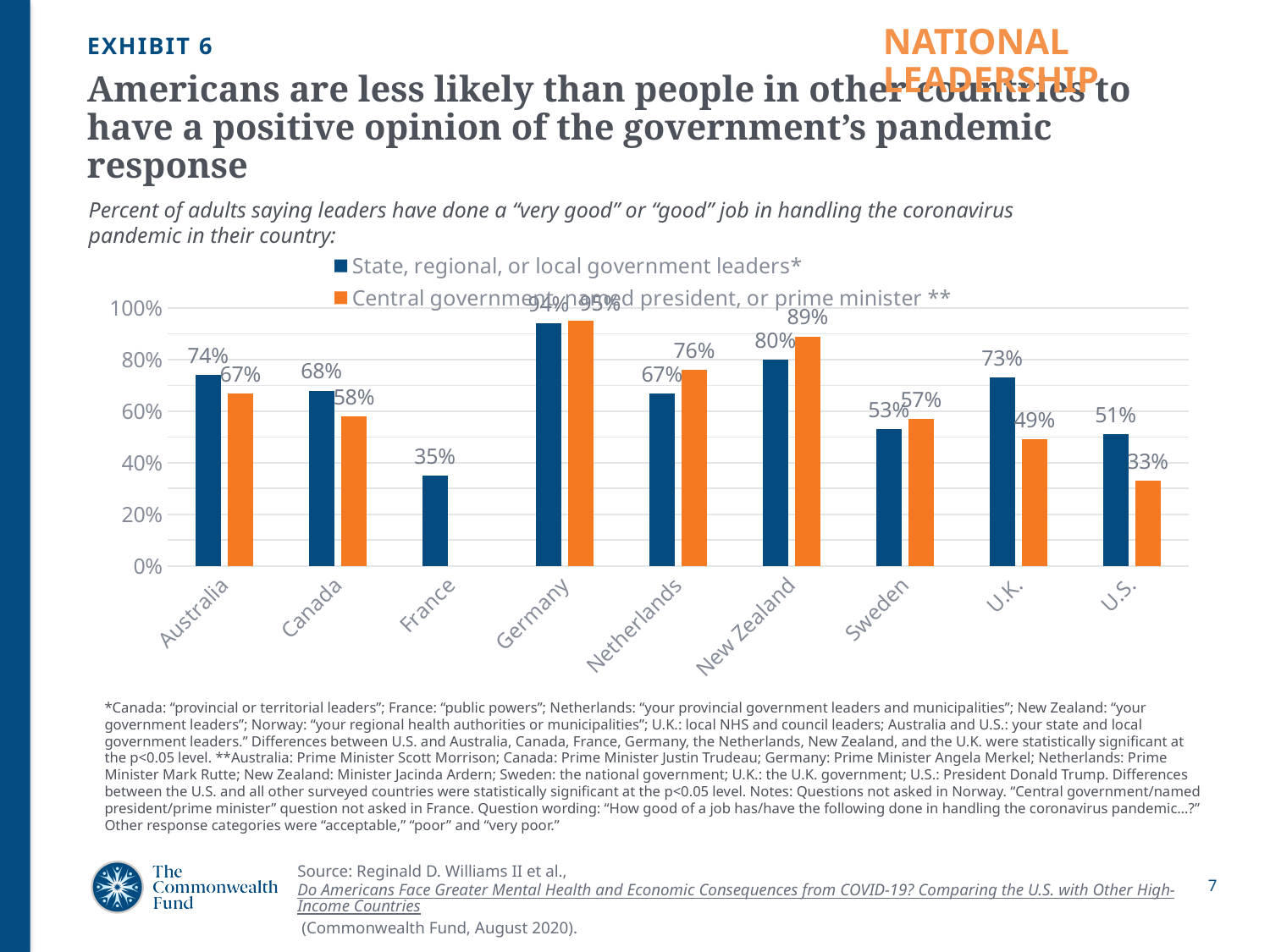
Which country has the highest value for state, regional, or local government leaders? Germany What type of chart is shown on the slide? Bar chart How many countries are shown on the x axis of the chart? 9 Which country has the lowest value for the central government, named president, or prime minister series? U.S. How many series does the chart legend list? 2 What is the value for the central government, named president, or prime minister series for the U.S.? 33% What is the value for state, regional, or local government leaders in France? 35% For the Netherlands, which series has the larger value: state, regional, or local government leaders, or central government, named president, or prime minister? Central government, named president, or prime minister Which country has no bar for the central government, named president, or prime minister series? France What percent of adults in Australia say state, regional, or local government leaders have done a very good or good job? 74% What is the difference between the U.K.'s value for state, regional, or local government leaders and its value for central government, named president, or prime minister? 24% What is the value for the central government, named president, or prime minister series for New Zealand? 89%